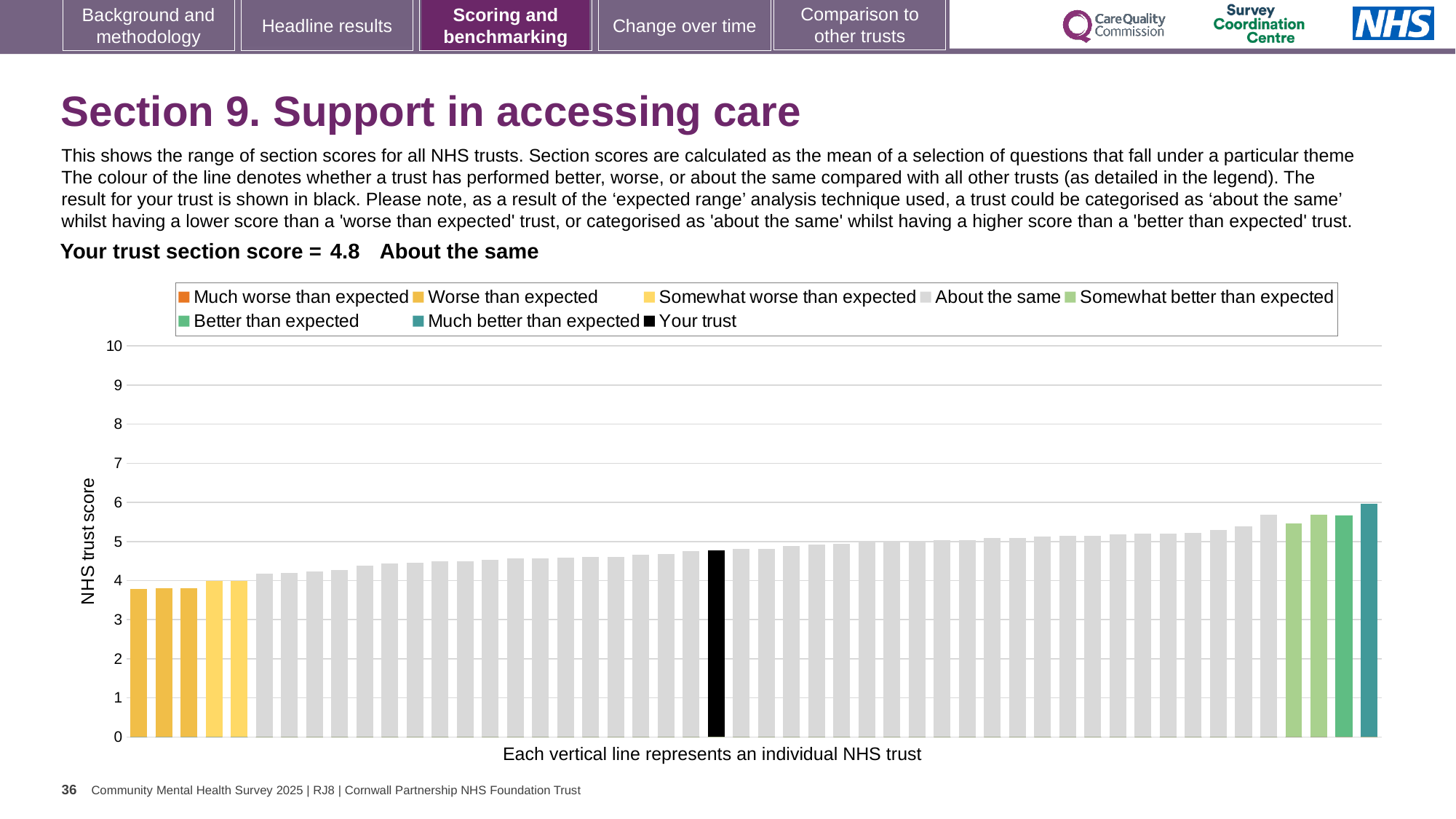
Which legend category do the lowest-scoring trusts (the leftmost bars) belong to? Worse than expected What is the title of the vertical axis of the chart? NHS trust score Is the value of the leftmost bar on the chart greater or less than 5? less Do the bar values rise or fall from left to right along the x axis? rise Is the value of the tallest bar on the chart greater or less than 5? greater How many entries does the chart legend list? 8 Which performance category is your trust placed in for this section? About the same What kind of chart is shown on the slide? bar chart Which legend category does the highest-scoring trust (the rightmost bar) belong to? Much better than expected What is the section score for your trust shown on the slide? 4.8 Is the value of the black bar for your trust greater or less than 5? less